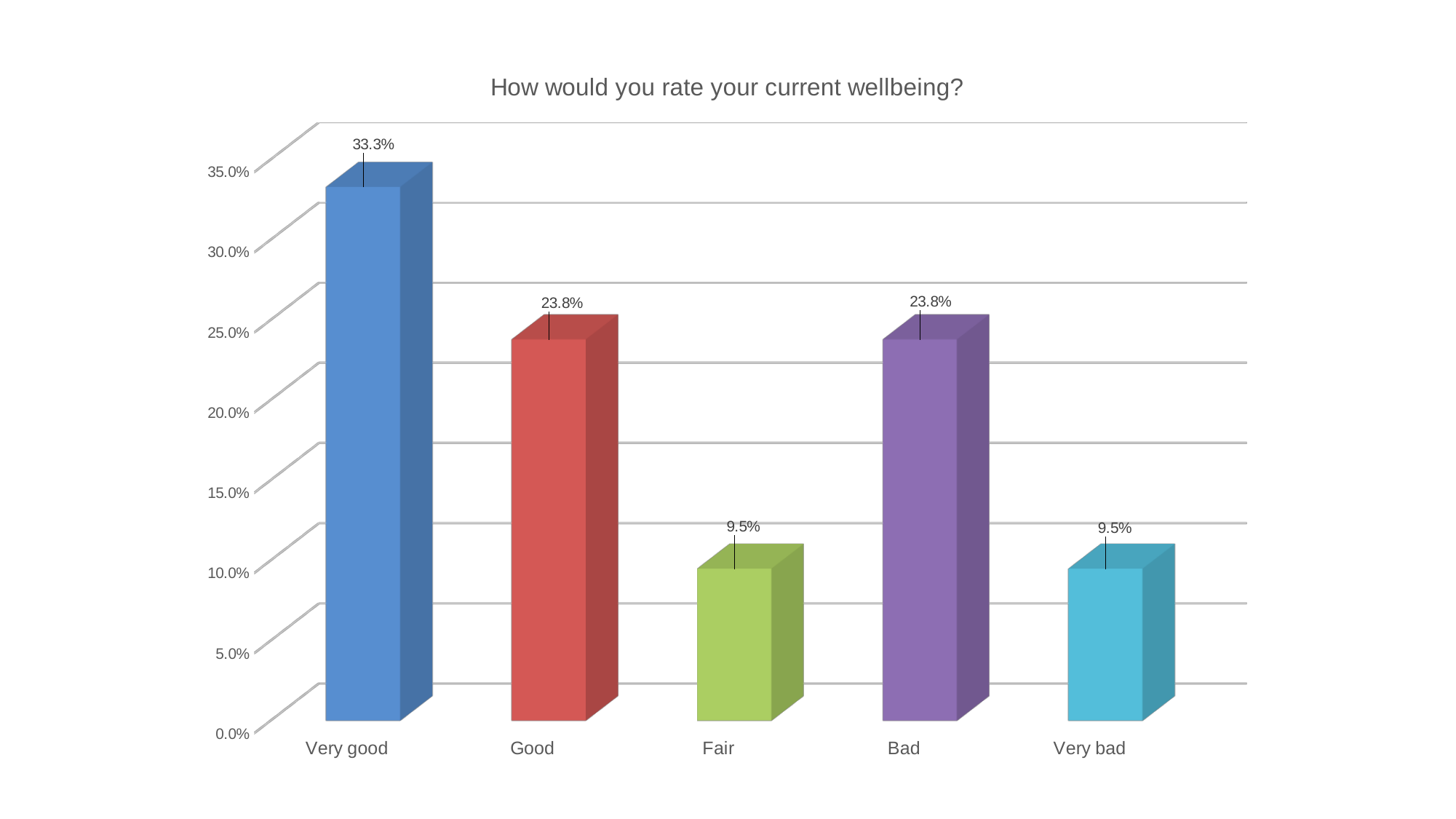
Is the value for 'Very good' greater or less than 30.0%? greater What percentage of respondents rated their current wellbeing as 'Very good'? 33.3% How many categories are shown on the x axis? 5 Which is larger, the value for 'Good' or the value for 'Fair'? Good What percentage is shown for 'Bad'? 23.8% What is the title of the chart? How would you rate your current wellbeing? Is the value for 'Very bad' greater or less than 10.0%? less What is the difference between the 'Very good' and 'Good' values? 9.5% Which category has the highest value? Very good What kind of chart is shown on the slide? Bar chart What is the difference between the 'Bad' and 'Very bad' values? 14.3% What is the value shown for the 'Fair' category? 9.5%